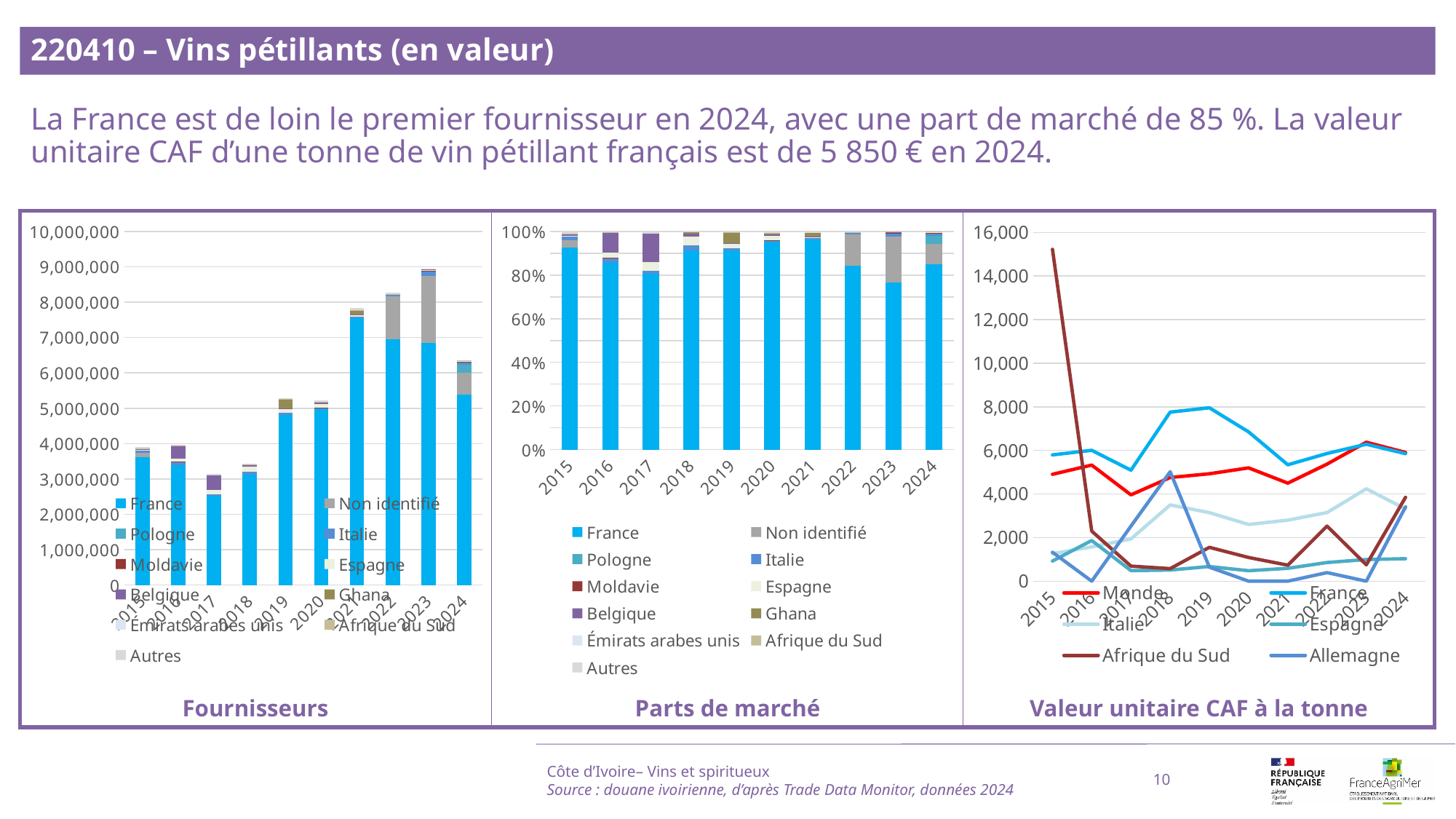
In the 'Parts de marché' chart, is the share for France in 2015 greater or less than 90%? greater In the 'Parts de marché' chart, which year has the lowest share for France? 2023 What kind of chart is the 'Fournisseurs' chart? bar chart In the 'Fournisseurs' chart, is the total for 2017 greater or less than 4,000,000? less In the 'Fournisseurs' chart, which year has the lowest total bar? 2017 In the 'Valeur unitaire CAF à la tonne' chart, is the value for Afrique du Sud in 2015 greater or less than 14,000? greater How many series does the legend of the 'Valeur unitaire CAF à la tonne' chart list? 6 In the 'Valeur unitaire CAF à la tonne' chart, which is larger in 2019, France or Monde? France How many series does the legend of the 'Fournisseurs' chart list? 11 In the 'Fournisseurs' chart, which year has the highest total bar? 2023 How many years are shown on the x axis of the 'Fournisseurs' chart? 10